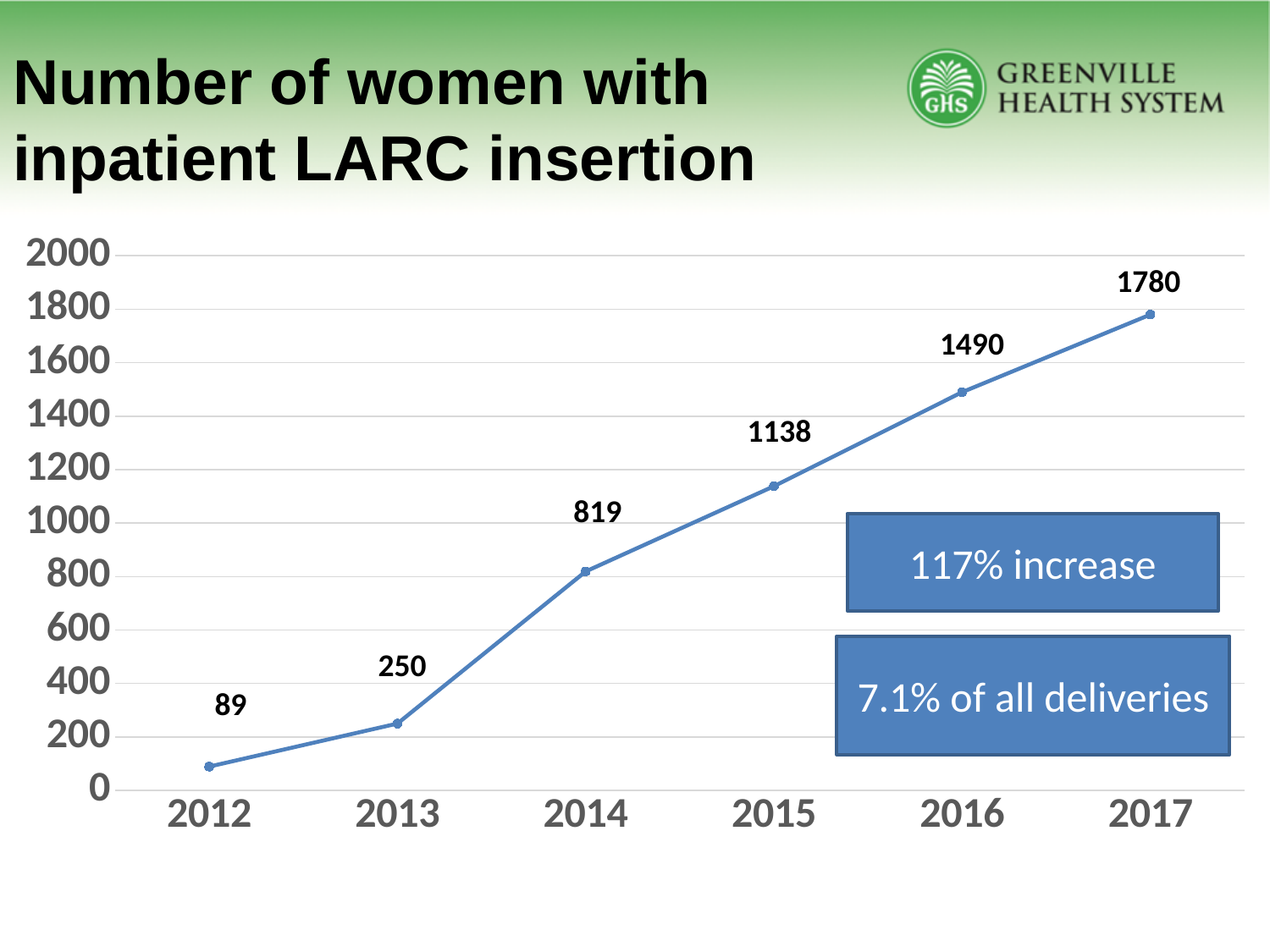
Which year has the lowest number of women with inpatient LARC insertion? 2012 What is the value for 2017? 1780 How many years are plotted on the chart? 6 Which is larger, the value for 2015 or the value for 2014? 2015 What is the difference between the values for 2016 and 2015? 352 What is the difference between the values for 2013 and 2012? 161 What percentage increase is stated in the text box on the chart? 117% What is the value for 2012? 89 How many women had inpatient LARC insertion in 2014? 819 Which year has the highest number of women with inpatient LARC insertion? 2017 Do the values rise or fall from 2012 to 2017? rise What type of chart is shown on the slide? line chart